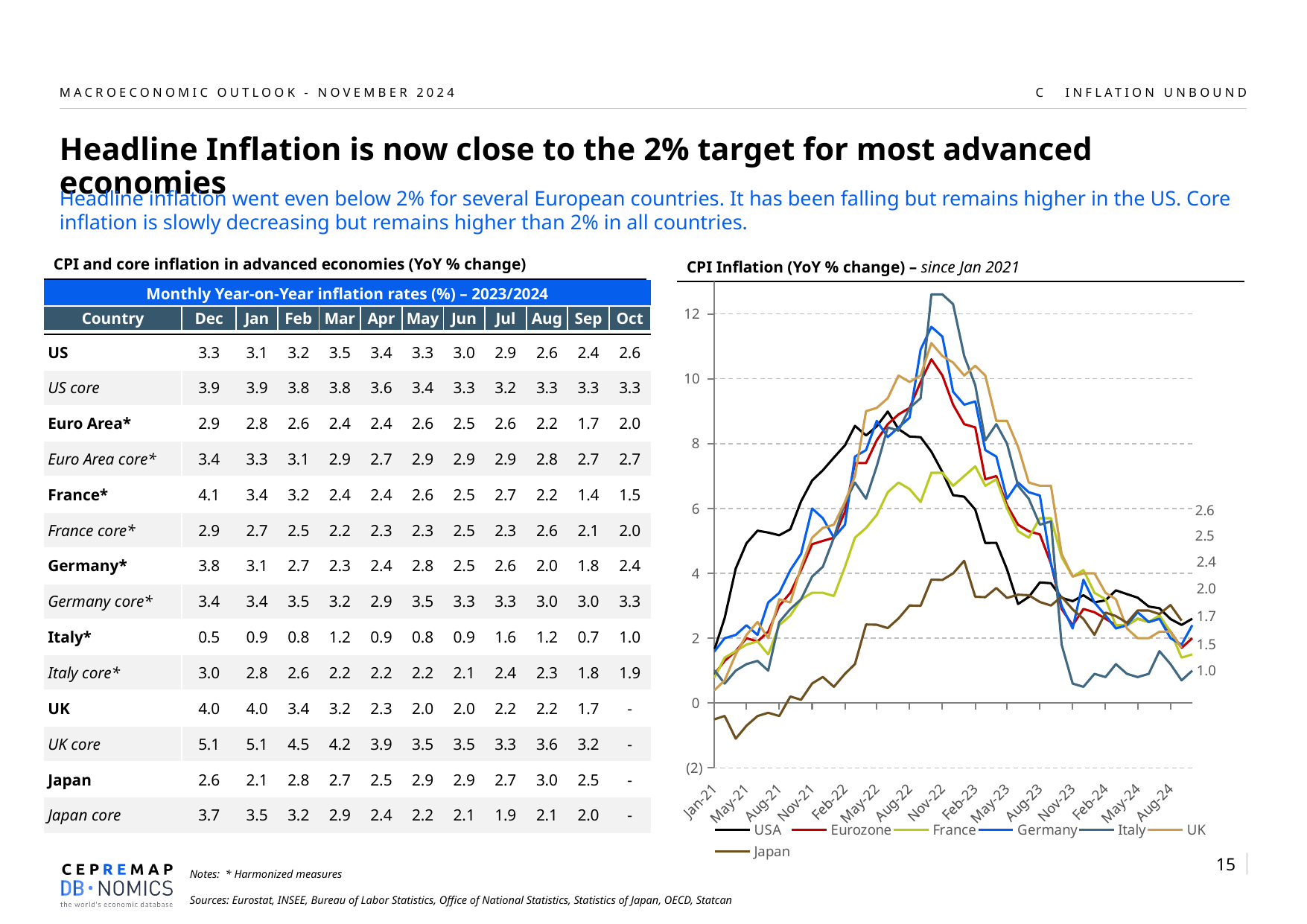
In the CPI Inflation line chart, what is the lowest value labelled at the right end of the lines? 1.0 How many series does the legend of the CPI Inflation line chart list? 7 What is the highest tick value shown on the y axis of the CPI Inflation line chart? 12 Which series in the CPI Inflation line chart has the lowest value at the right end of the chart (Aug-24 onward)? Italy In the CPI Inflation line chart, do the values generally rise or fall between Nov-22 and Aug-24? fall What kind of chart is the 'CPI Inflation (YoY % change) – since Jan 2021' chart? line chart In the CPI Inflation line chart, is the peak value for USA greater or less than 8? greater In the CPI Inflation line chart, which series is higher in Jan-21: USA or Japan? USA In the CPI Inflation line chart, is the value for Japan in Jan-21 greater or less than 0? less Which series in the CPI Inflation line chart reaches the highest peak? Italy In the CPI Inflation line chart, is the peak value for Italy greater or less than 12? greater In the CPI Inflation line chart, what is the highest value labelled at the right end of the lines? 2.6